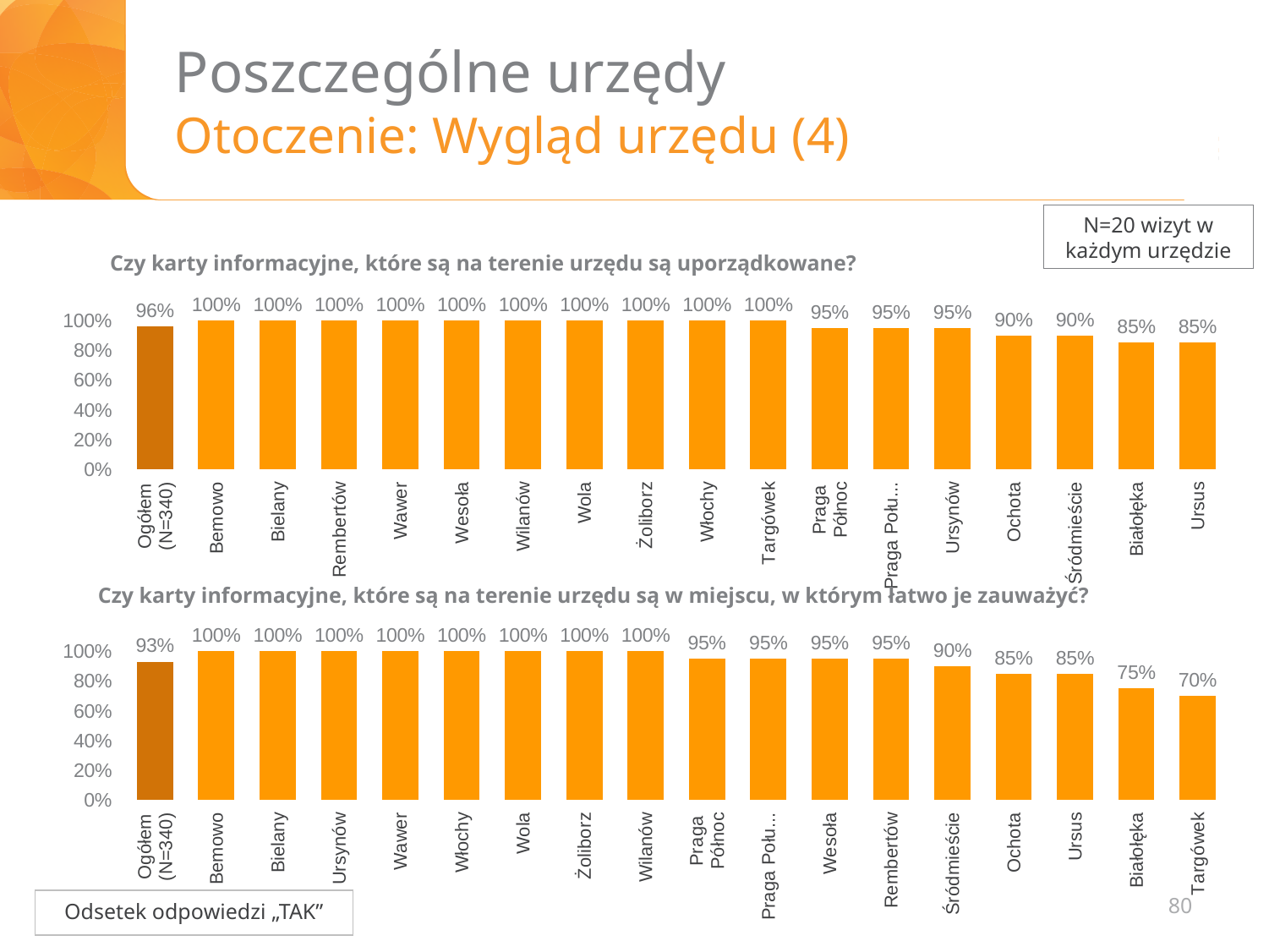
In the top chart, what is the value for Ochota? 90% In the bottom chart, what is the difference between the values for Bemowo and Białołęka? 25% What type of chart is the bottom chart? Bar chart In the top chart, what is the value for Ursus? 85% In the bottom chart, what is the value for Ogółem (N=340)? 93% How many bars are plotted in the top chart? 18 In the bottom chart ("Czy karty informacyjne ... łatwo je zauważyć?"), what is the value for Targówek? 70% In the top chart, what is the difference between the values for Targówek and Białołęka? 15% In the bottom chart, which is larger: the value for Śródmieście or the value for Ursus? Śródmieście According to the note on the slide, how many visits were made in each office (N)? N=20 In the top chart ("Czy karty informacyjne, które są na terenie urzędu są uporządkowane?"), what is the value for Ogółem (N=340)? 96% In the bottom chart, which category has the lowest value? Targówek